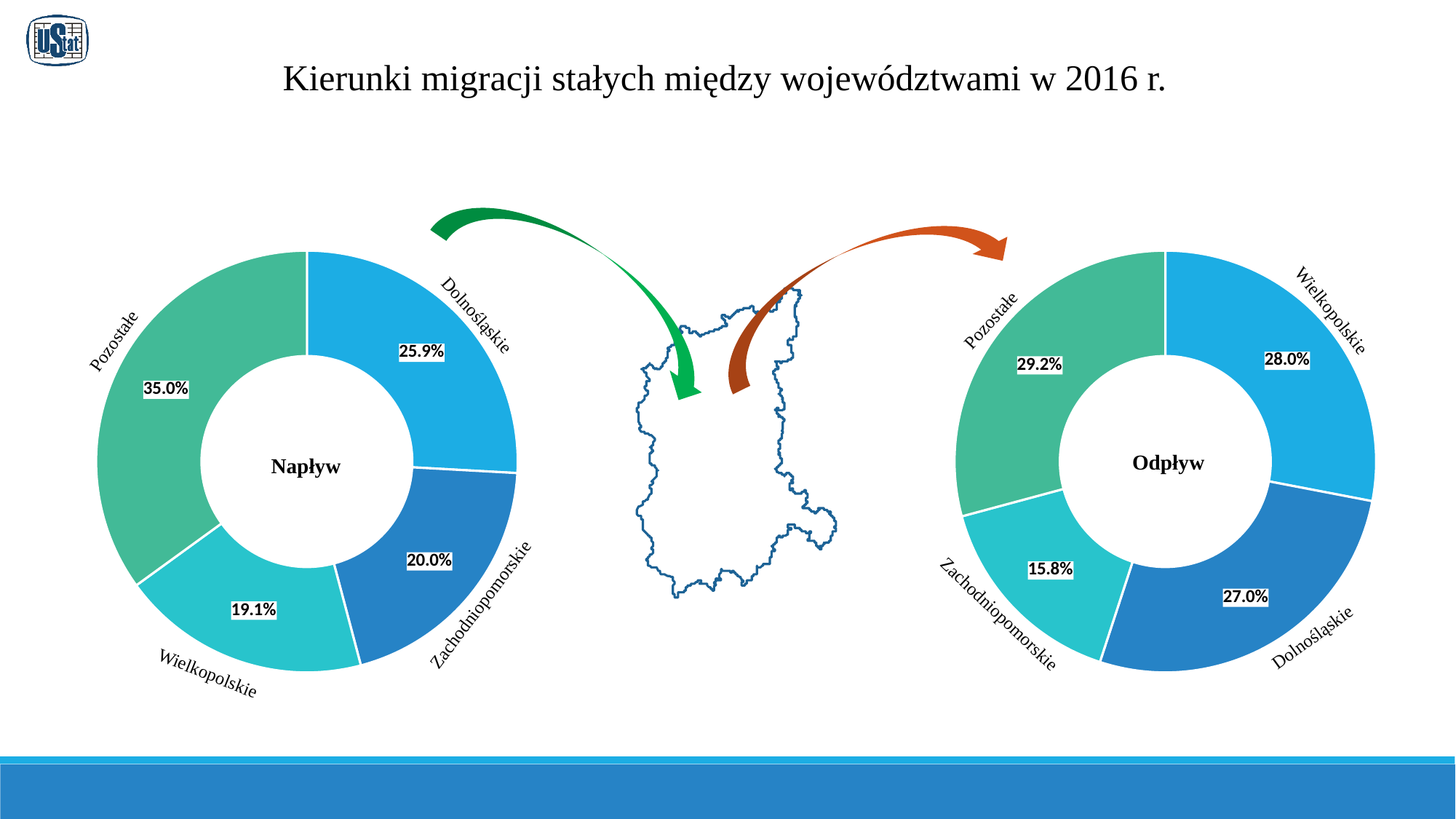
In the Napływ chart, which category has the smallest share? Wielkopolskie In the Napływ chart, what is the share for Pozostałe? 35.0% What kind of chart is the Odpływ chart? Doughnut (pie) chart How many categories does the Napływ chart show? 4 In the Odpływ chart, what is the share for Dolnośląskie? 27.0% In the Odpływ chart, which category has the smallest share? Zachodniopomorskie In the Odpływ chart, what is the share for Zachodniopomorskie? 15.8% In the Odpływ chart, which is larger: the share for Wielkopolskie or the share for Dolnośląskie? Wielkopolskie What is the title of the slide? Kierunki migracji stałych między województwami w 2016 r. In the Odpływ chart, which category has the largest share? Pozostałe In the Napływ chart, what is the difference between the shares for Dolnośląskie and Zachodniopomorskie? 5.9% In the Napływ chart, what is the share for Wielkopolskie? 19.1%